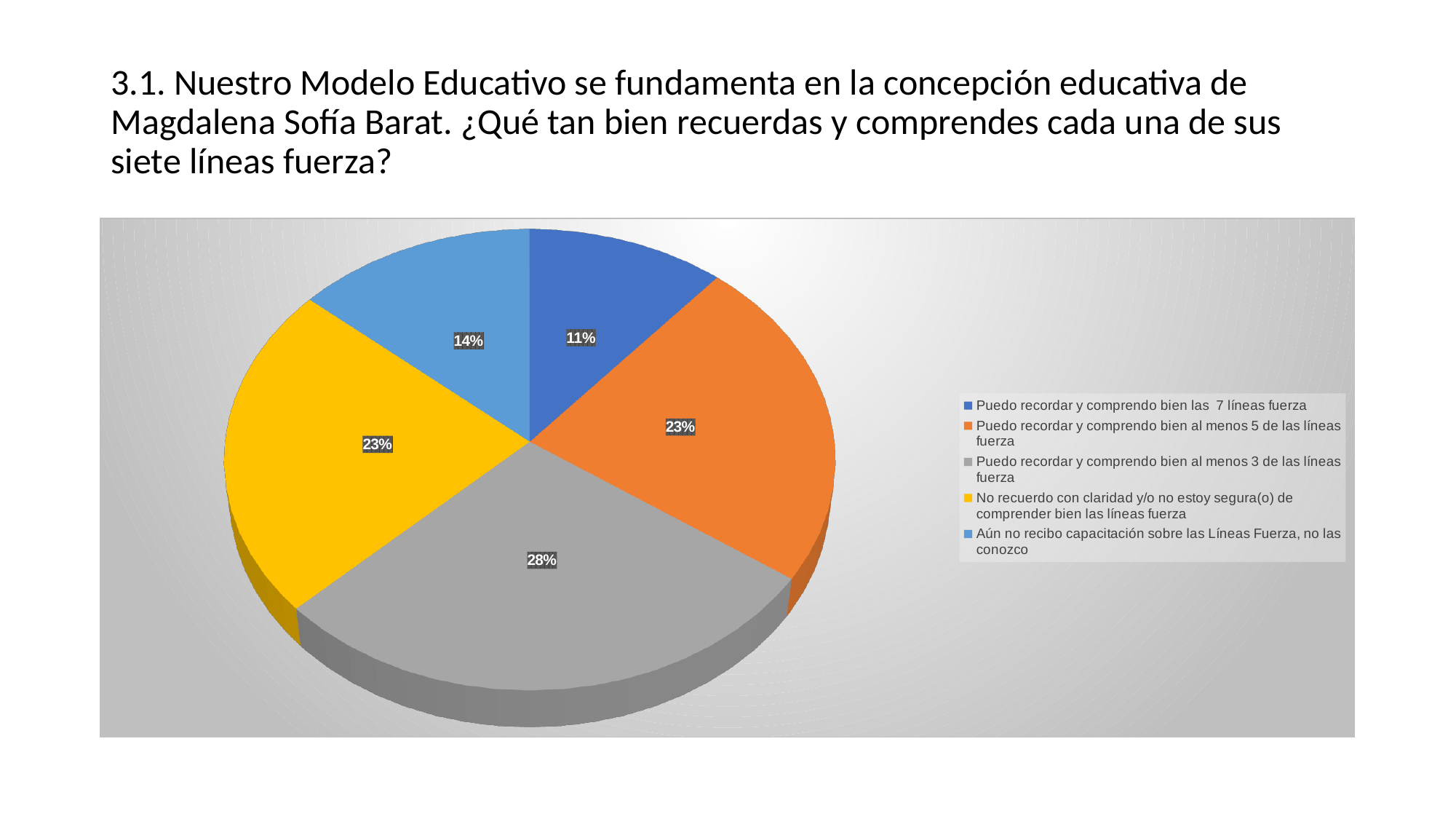
How many categories does the pie chart have? 5 Which response category has the largest share of the pie? Puedo recordar y comprendo bien al menos 3 de las líneas fuerza What kind of chart is shown on the slide? Pie chart What percentage of respondents said 'Puedo recordar y comprendo bien al menos 3 de las líneas fuerza'? 28% What percentage of respondents said 'Aún no recibo capacitación sobre las Líneas Fuerza, no las conozco'? 14% What percentage of respondents said 'Puedo recordar y comprendo bien al menos 5 de las líneas fuerza'? 23% What colour is the slice for 'No recuerdo con claridad y/o no estoy segura(o) de comprender bien las líneas fuerza'? Yellow Which is larger: the share for 'Aún no recibo capacitación sobre las Líneas Fuerza, no las conozco' or the share for 'Puedo recordar y comprendo bien las 7 líneas fuerza'? Aún no recibo capacitación sobre las Líneas Fuerza, no las conozco What percentage of respondents said 'Puedo recordar y comprendo bien las 7 líneas fuerza'? 11% Which response category has the smallest share of the pie? Puedo recordar y comprendo bien las 7 líneas fuerza What is the combined share of the two 23% slices? 46% What is the difference in percentage points between 'Puedo recordar y comprendo bien al menos 3 de las líneas fuerza' and 'Puedo recordar y comprendo bien las 7 líneas fuerza'? 17